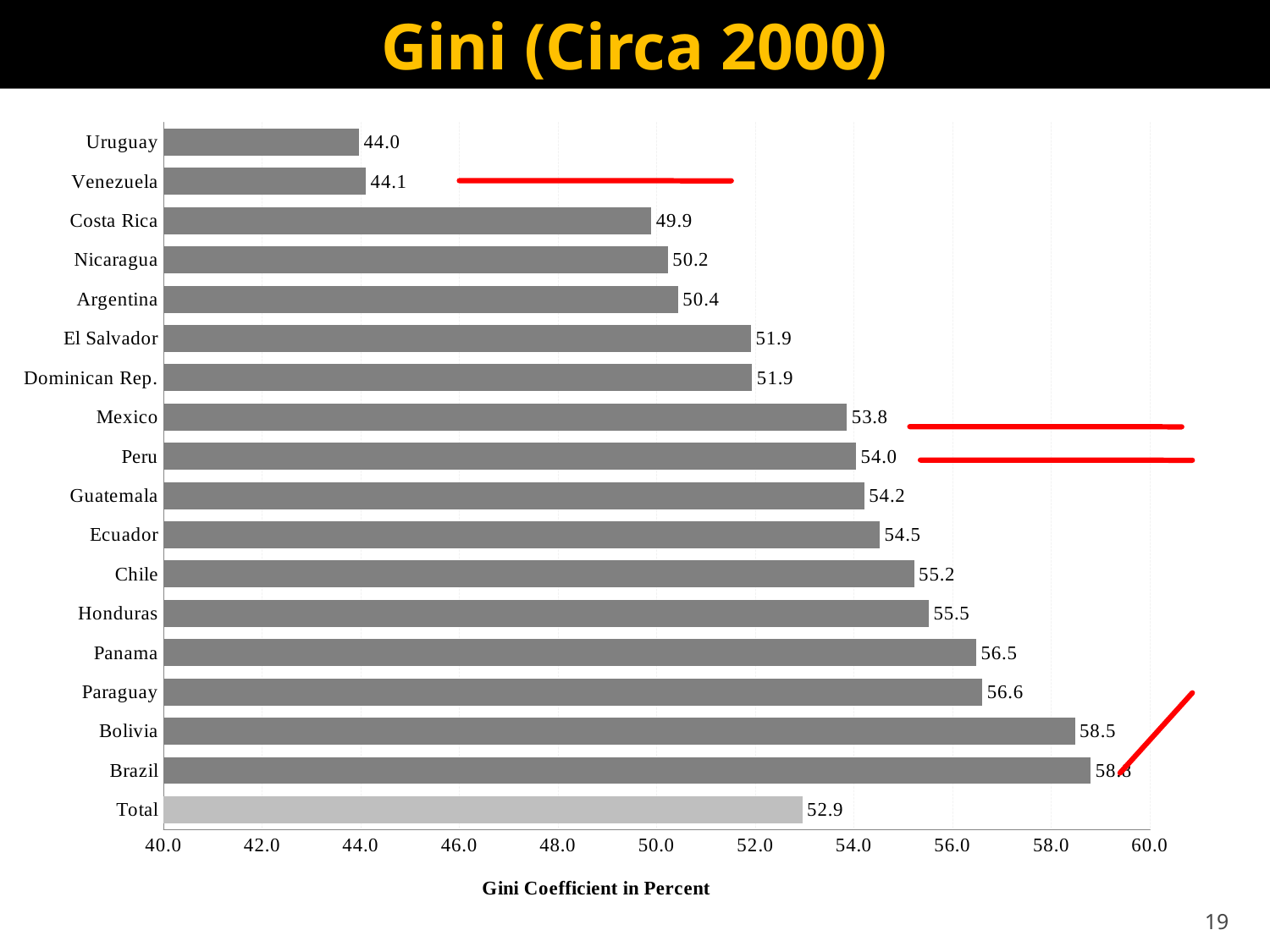
Is the value for Honduras greater or less than 54.0? greater What is the value shown for Costa Rica? 49.9 What is the difference between the values for Paraguay and Panama? 0.1 What is the value shown for the Total bar? 52.9 What type of chart is shown on the slide? Bar chart What is the Gini coefficient shown for Bolivia? 58.5 Which has a higher value, Chile or Argentina? Chile What is the Gini coefficient shown for Mexico? 53.8 What is the value shown for Uruguay? 44.0 What is the label of the horizontal axis? Gini Coefficient in Percent What is the difference between the values for Peru and Uruguay? 10.0 How many bars are shown in the chart? 18